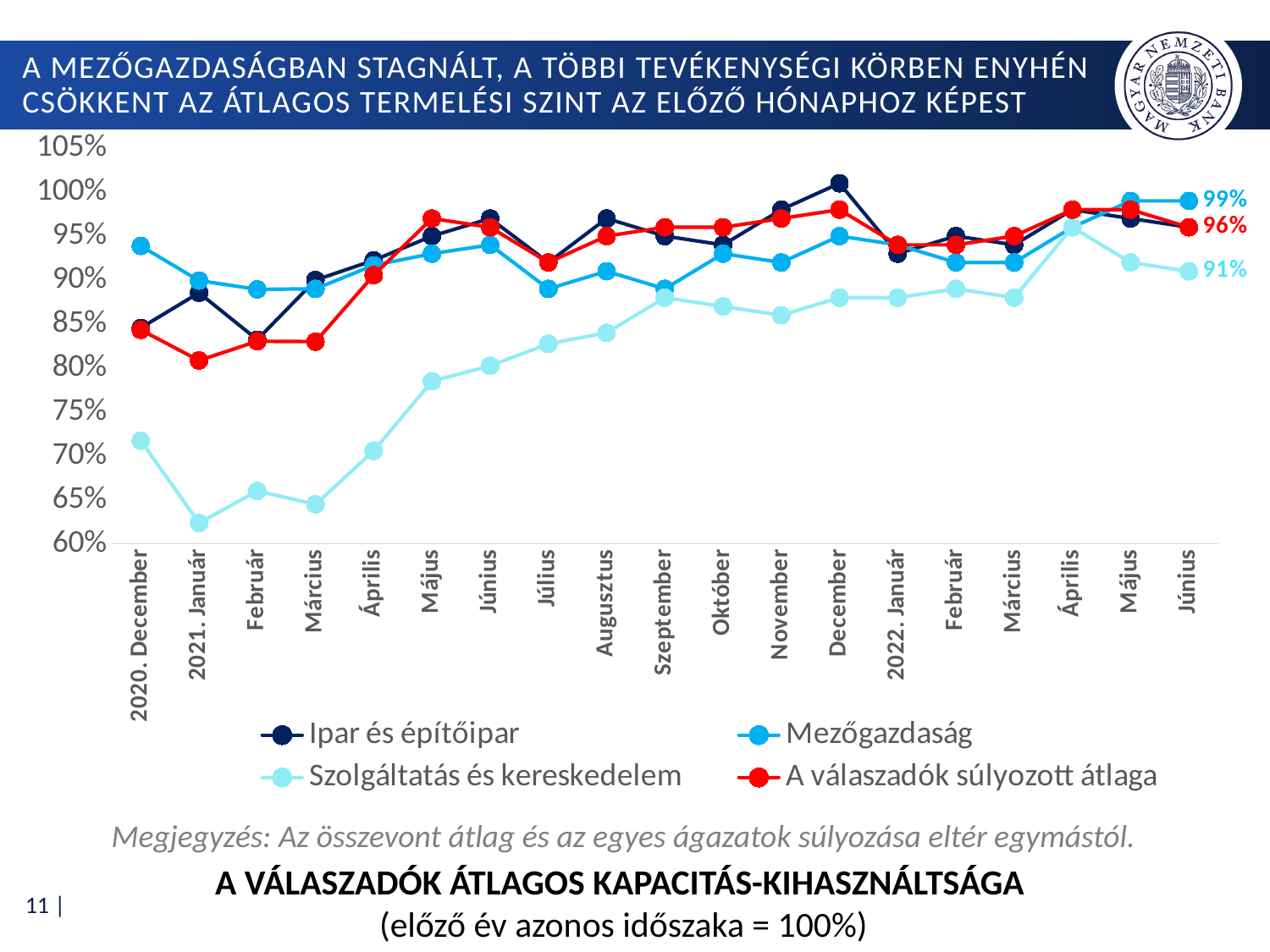
What kind of chart is shown on the slide? Line chart What is the value of A válaszadók súlyozott átlaga for Június 2022? 96% How many months (data points) are shown along the x axis? 19 How many series does the legend list? 4 What is the value of the Mezőgazdaság series for Június 2022? 99% What is the difference between the Mezőgazdaság and Szolgáltatás és kereskedelem values for Június 2022? 8 percentage points What is the value of the Szolgáltatás és kereskedelem series for Június 2022? 91% In which month does the Szolgáltatás és kereskedelem series reach its lowest value? 2021. Január Is the value for Szolgáltatás és kereskedelem in 2021. Január greater or less than 65%? less Is the value for Ipar és építőipar in December 2021 greater or less than 100%? greater What is the title of the chart shown below the legend? A válaszadók átlagos kapacitás-kihasználtsága (előző év azonos időszaka = 100%) Which series has the larger value in Június 2022: Mezőgazdaság or Szolgáltatás és kereskedelem? Mezőgazdaság